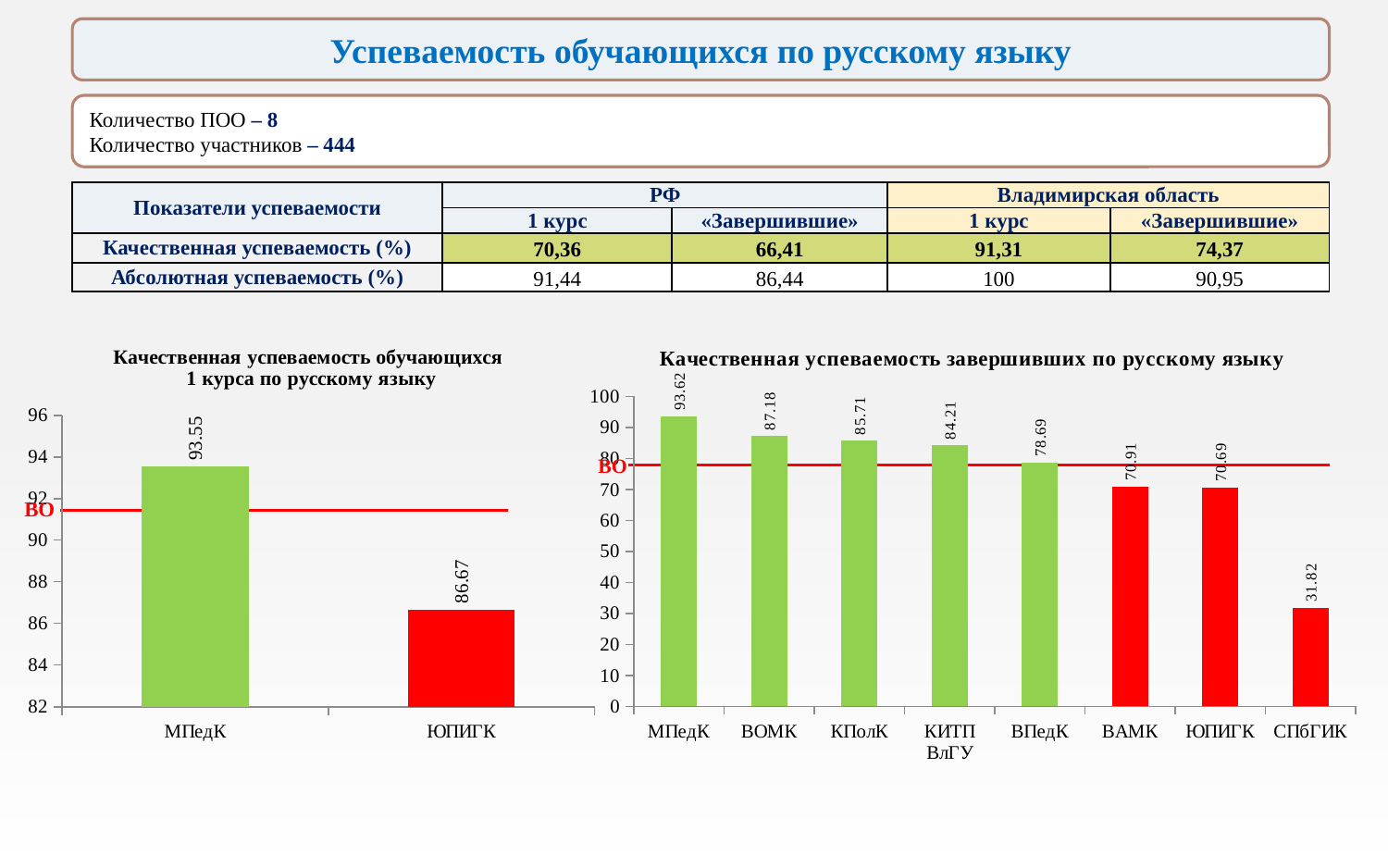
In the chart 'Качественная успеваемость завершивших по русскому языку', how many categories are shown? 8 In the chart 'Качественная успеваемость обучающихся 1 курса по русскому языку', what is the difference between the values for МПедК and ЮПИГК? 6.88 In the chart 'Качественная успеваемость завершивших по русскому языку', what is the value for СПбГИК? 31.82 In the chart 'Качественная успеваемость обучающихся 1 курса по русскому языку', how many categories are shown? 2 In the chart 'Качественная успеваемость завершивших по русскому языку', which is larger: the value for КИТП ВлГУ or the value for ВАМК? КИТП ВлГУ In the chart 'Качественная успеваемость завершивших по русскому языку', which category has the highest value? МПедК In the chart 'Качественная успеваемость завершивших по русскому языку', what is the difference between the values for КПолК and ВПедК? 7.02 In the chart 'Качественная успеваемость обучающихся 1 курса по русскому языку', what is the value for ЮПИГК? 86.67 In the chart 'Качественная успеваемость обучающихся 1 курса по русскому языку', what is the value for МПедК? 93.55 In the chart 'Качественная успеваемость завершивших по русскому языку', what is the value for ВОМК? 87.18 In the chart 'Качественная успеваемость завершивших по русскому языку', which category has the lowest value? СПбГИК What type of chart is the chart on the right side of the slide? bar chart